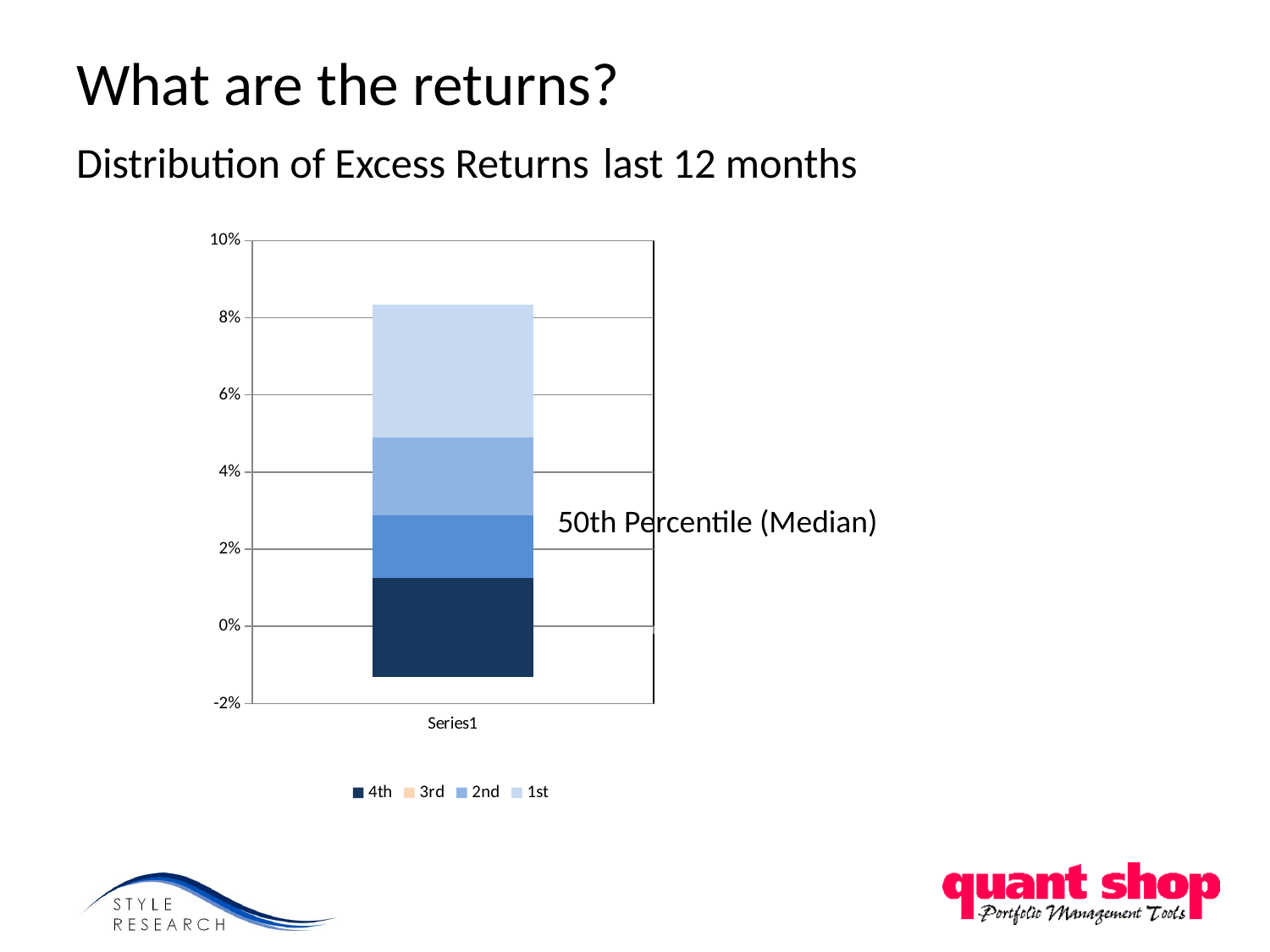
Which legend entry corresponds to the darkest segment at the bottom of the stacked bar? 4th What kind of chart is shown on the slide? stacked bar chart How many categories are plotted along the x axis of the chart? 1 Is the top of the stacked bar for Series1 greater or less than 6%? greater Is the top of the stacked bar for Series1 greater or less than 10%? less What are the four entries listed in the chart legend? 4th, 3rd, 2nd, 1st What is the lowest value shown on the chart's vertical axis? -2% Is the bottom of the stacked bar for Series1 greater or less than 0%? less What text annotation is placed beside the stacked bar on the chart? 50th Percentile (Median) What is the label of the single category on the x axis? Series1 What is the highest value shown on the chart's vertical axis? 10% How many series does the chart legend list? 4